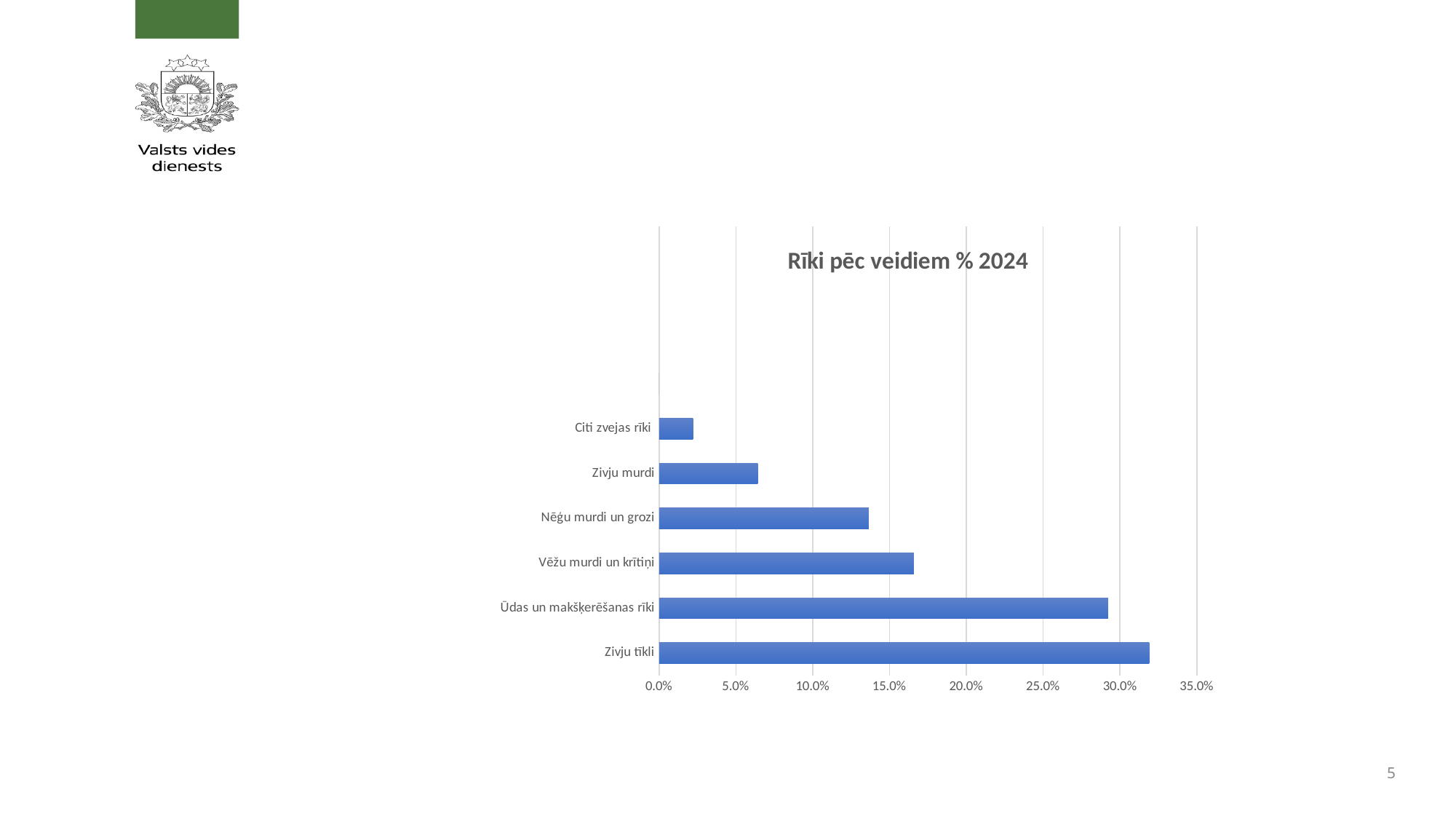
What kind of chart is shown on the slide? bar chart Which is larger, the value for Zivju murdi or the value for Nēģu murdi un grozi? Nēģu murdi un grozi Is the value for Zivju murdi greater or less than 5.0%? greater What is the highest value shown on the horizontal axis? 35.0% Is the value for Zivju tīkli greater or less than 30.0%? greater Is the value for Ūdas un makšķerēšanas rīki greater or less than 30.0%? less Which category has the lowest value? Citi zvejas rīki Which category has the highest value? Zivju tīkli How many categories are plotted in the chart? 6 What is the title of the chart? Rīki pēc veidiem % 2024